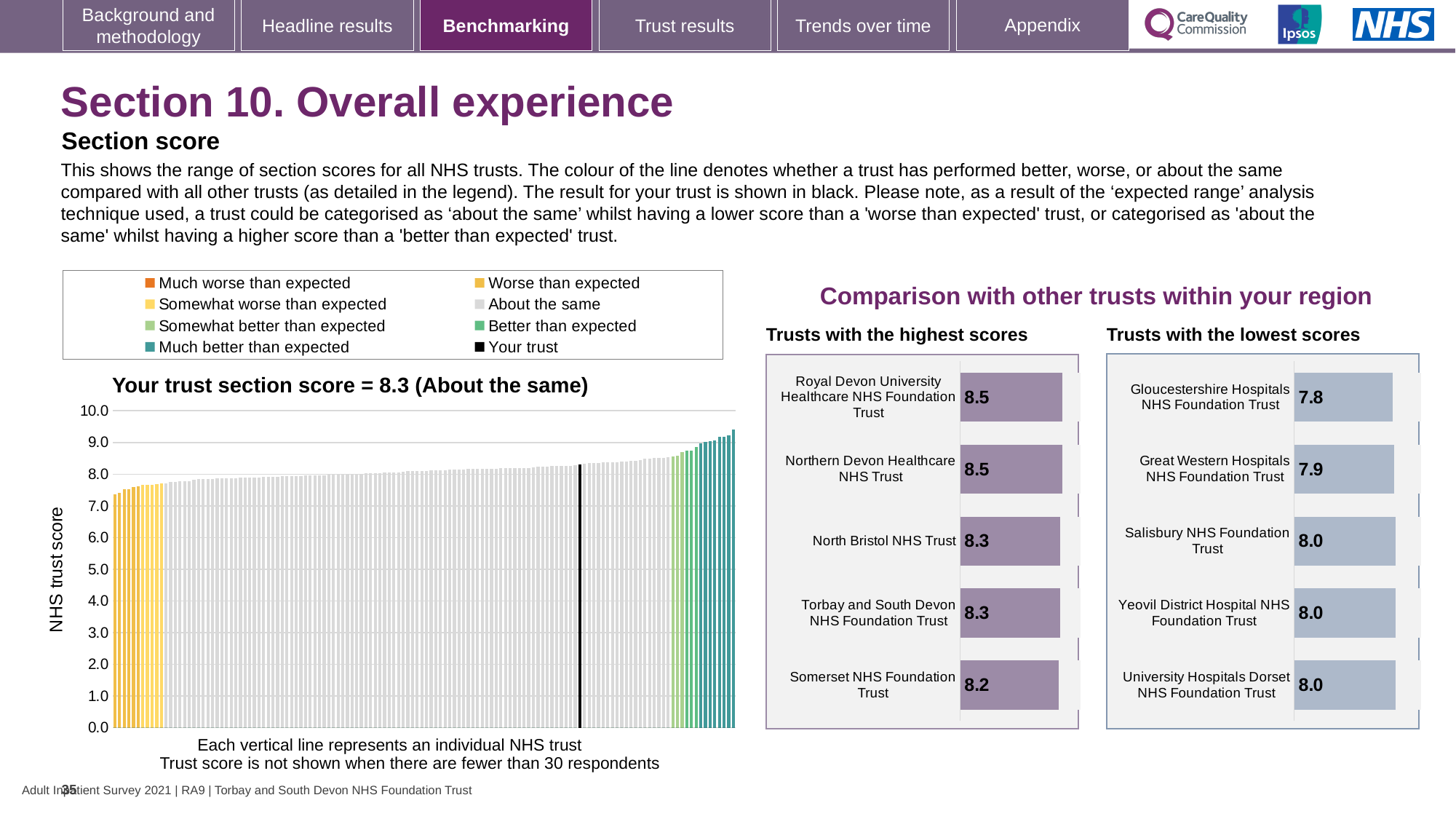
In the 'Your trust section score' chart, is the value of the leftmost (lowest) bar greater or less than 8.0? less What is the y-axis label of the 'Your trust section score' chart? NHS trust score In the 'Trusts with the highest scores' chart, which trust has the lowest score? Somerset NHS Foundation Trust How many entries does the legend above the 'Your trust section score' chart list? 8 In the 'Trusts with the highest scores' chart, what is the difference between the scores of Royal Devon University Healthcare NHS Foundation Trust and Somerset NHS Foundation Trust? 0.3 How many trusts are shown in the 'Trusts with the lowest scores' chart? 5 In the 'Trusts with the lowest scores' chart, which trust has the lowest score? Gloucestershire Hospitals NHS Foundation Trust In the 'Trusts with the lowest scores' chart, which has the larger score: Great Western Hospitals NHS Foundation Trust or Gloucestershire Hospitals NHS Foundation Trust? Great Western Hospitals NHS Foundation Trust What kind of chart is the 'Your trust section score' chart on the left of the slide? bar chart In the 'Your trust section score' chart, do the bar heights rise or fall from left to right? rise In the chart titled 'Your trust section score', what is the section score for your trust? 8.3 In the 'Trusts with the highest scores' chart, what is the score for Somerset NHS Foundation Trust? 8.2